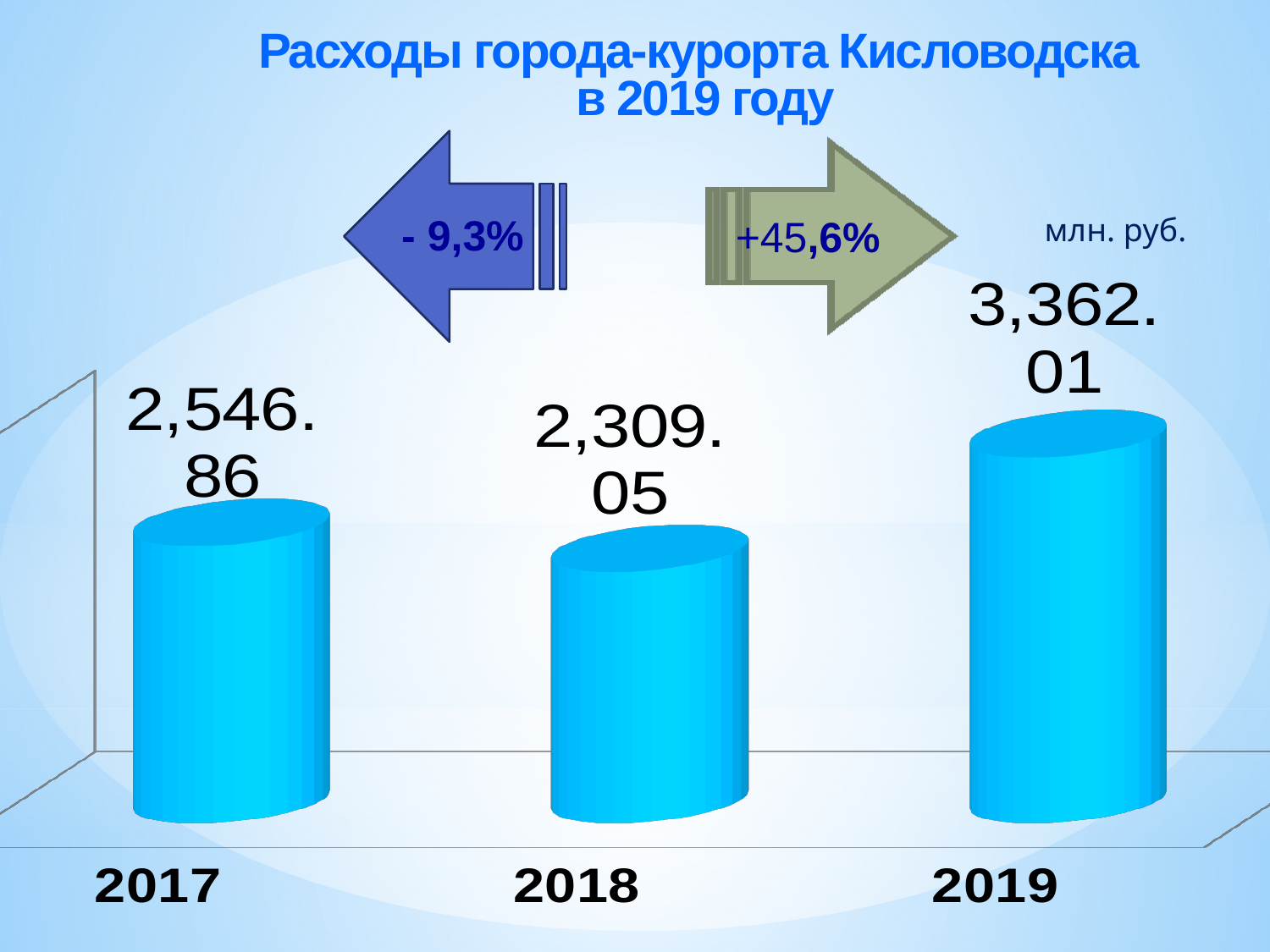
What is the difference between the values for 2019 and 2018? 1,052.96 What unit of measurement is indicated on the slide? млн. руб. Which year has the lowest value? 2018 What is the value shown for 2018? 2,309.05 What kind of chart is shown on the slide? Bar chart Which is larger, the value for 2017 or the value for 2019? 2019 How many years are shown on the chart? 3 What percentage change is shown in the arrow between 2018 and 2019? +45,6% What is the difference between the values for 2017 and 2018? 237.81 Which year has the highest value? 2019 What is the value shown for 2019? 3,362.01 What is the value shown for 2017? 2,546.86